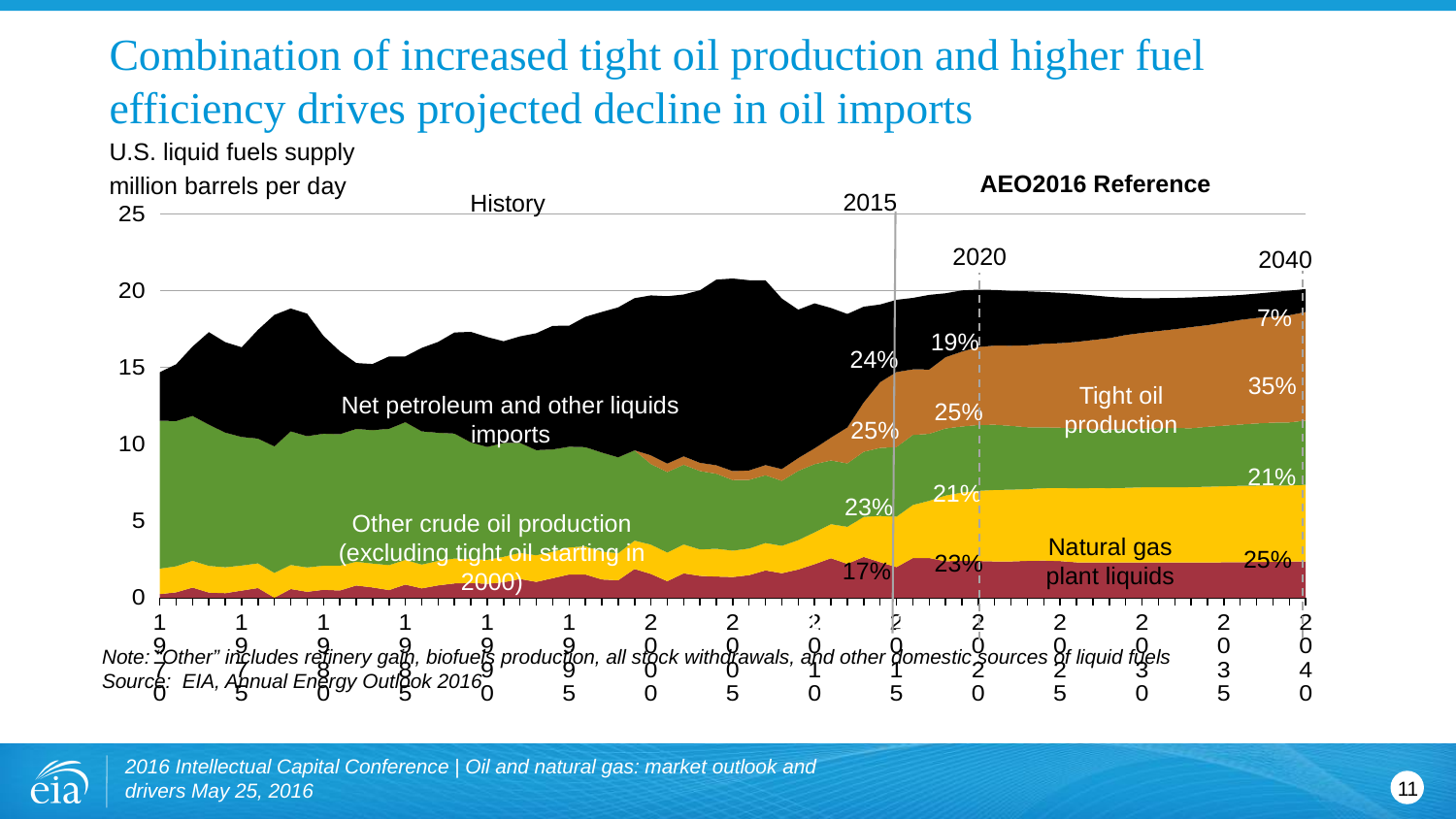
By how many percentage points does the labeled share of net petroleum and other liquids imports change from 2020 (19%) to 2040 (7%)? 12 percentage points Which labeled component has the largest share in 2040? Tight oil production What share is labeled for natural gas plant liquids in 2040? 25% What share is labeled for other crude oil production in 2040? 21% What unit is the y axis measured in? million barrels per day What share is labeled for tight oil production in 2040? 35% What share is labeled for net petroleum and other liquids imports in 2020? 19% What share of U.S. liquid fuels supply is labeled for net petroleum and other liquids imports in 2040? 7% Does the labeled share of net petroleum and other liquids imports rise or fall from 2015 to 2040? Fall What kind of chart is shown on the slide? Stacked area chart Which labeled component has the smallest share in 2040? Net petroleum and other liquids imports What share is labeled for natural gas plant liquids at 2015? 17%